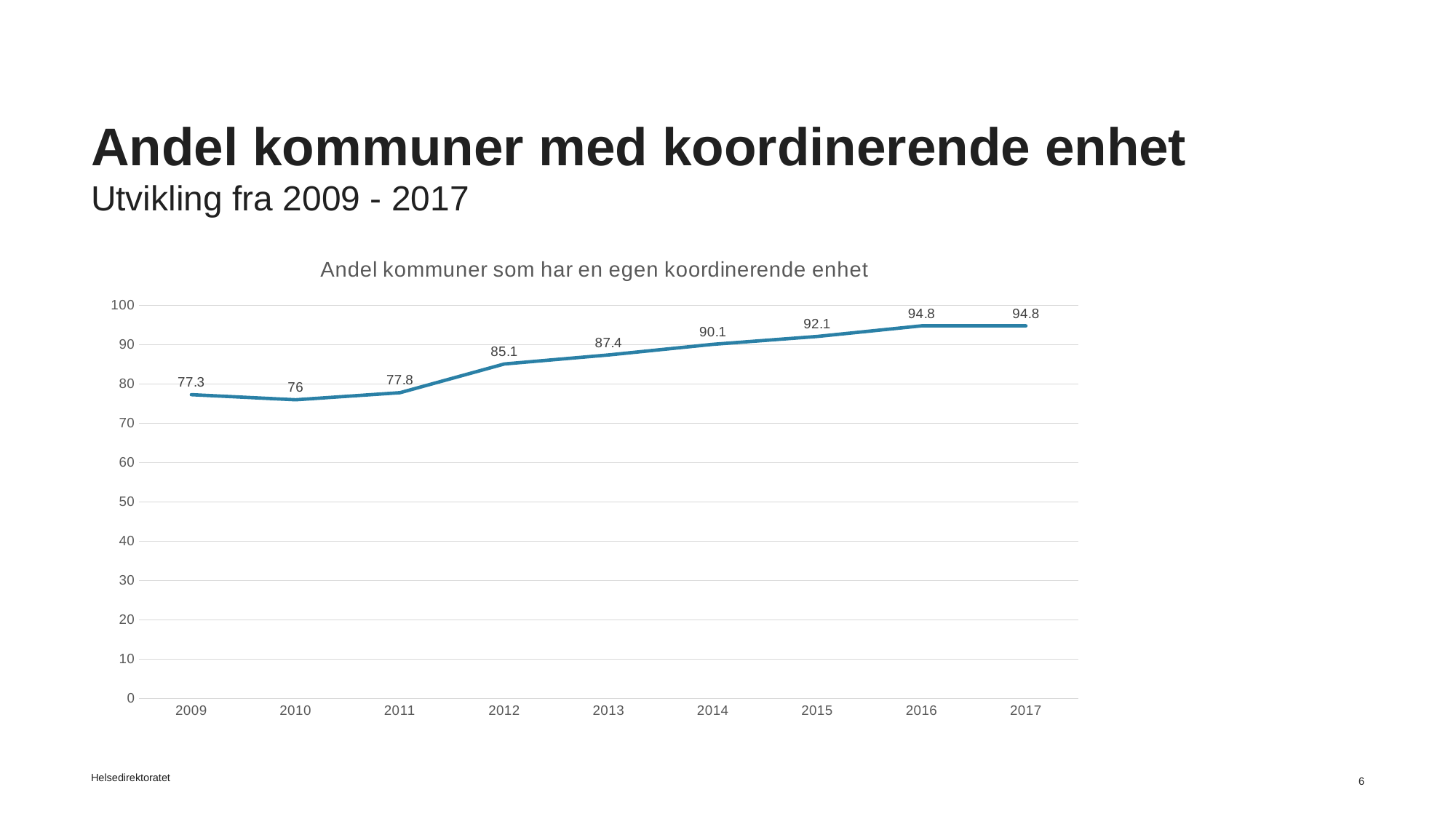
Which is larger, the value for 2013 or the value for 2011? 2013 What is the difference between the values for 2017 and 2009? 17.5 What is the value for 2009? 77.3 What is the difference between the values for 2012 and 2011? 7.3 What kind of chart is shown? line chart What is the value for 2012? 85.1 Is the value for 2014 greater or less than 80? greater Which year has the lowest value? 2010 What is the value for 2015? 92.1 Do the values generally rise or fall from 2011 to 2016? rise What is the title of the chart? Andel kommuner som har en egen koordinerende enhet How many years are plotted on the x axis? 9